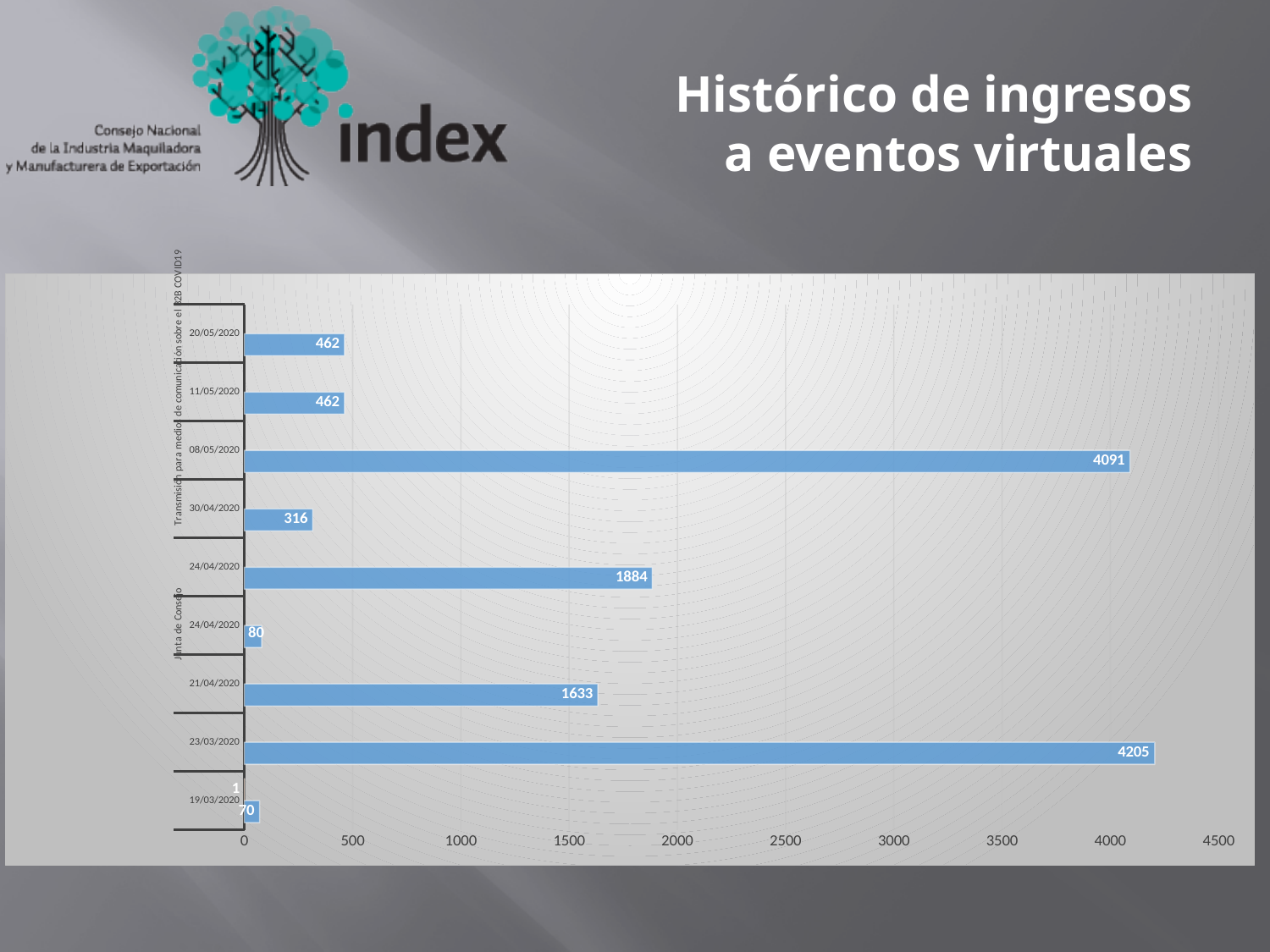
What is the value for 20/05/2020? 462 What is the value for 08/05/2020? 4091 What type of chart is shown on the slide? bar chart Which date has the highest value? 23/03/2020 Is the value for 11/05/2020 greater or less than 500? less What is the value for 30/04/2020? 316 What is the value for 23/03/2020? 4205 What is the difference between the values for 08/05/2020 and 30/04/2020? 3775 What is the value for 21/04/2020? 1633 Which is larger, the value for 21/04/2020 or the value for 30/04/2020? 21/04/2020 What is the difference between the values for 23/03/2020 and 08/05/2020? 114